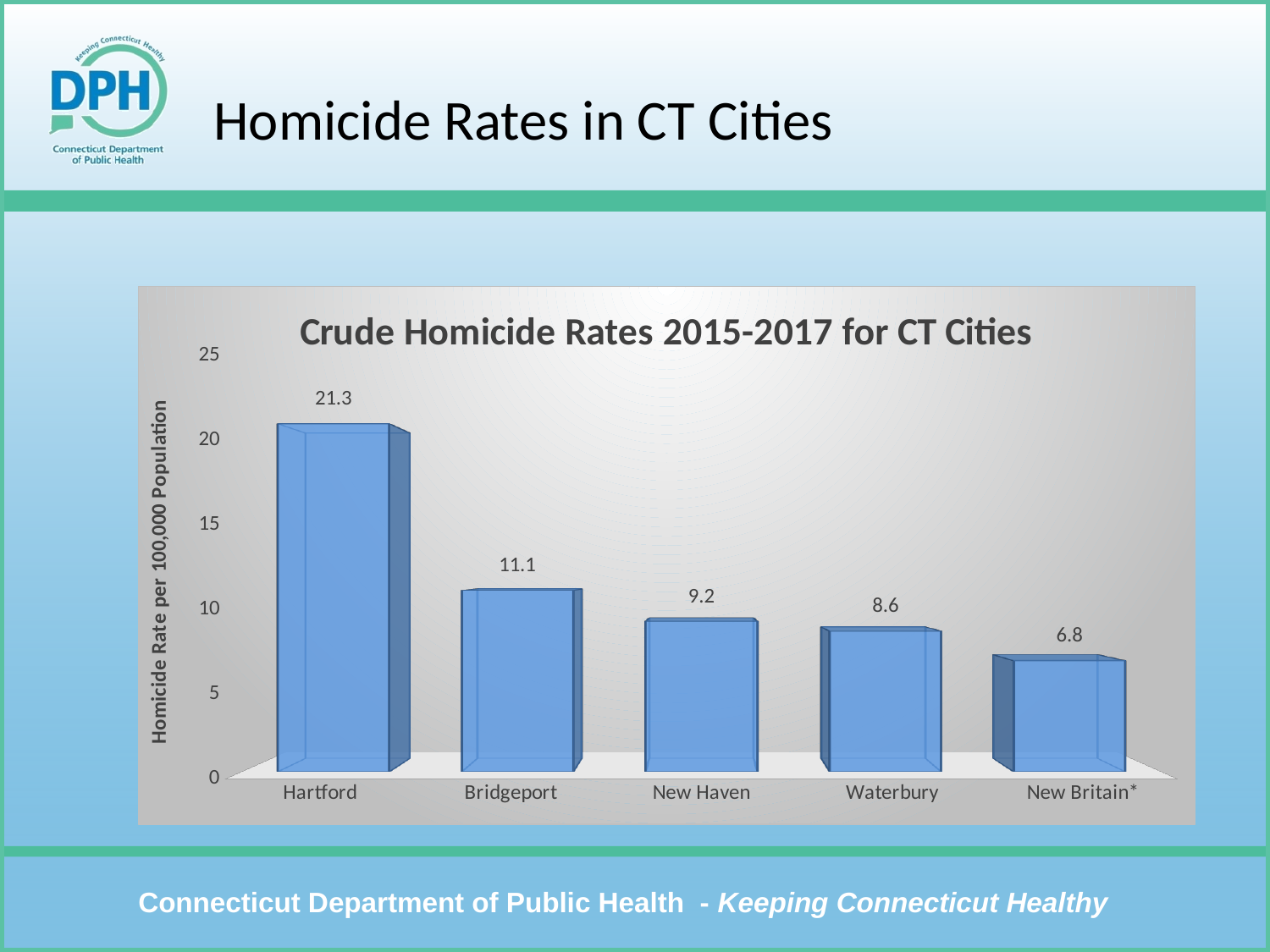
Which city has a higher homicide rate, Bridgeport or Waterbury? Bridgeport Which city has the highest crude homicide rate? Hartford What is the title of the chart? Crude Homicide Rates 2015-2017 for CT Cities Which city has the lowest crude homicide rate? New Britain* What is the crude homicide rate for New Britain*? 6.8 What is the crude homicide rate for Hartford? 21.3 Is the value for Hartford greater or less than 20? greater What is the difference between the homicide rates of Waterbury and New Britain*? 1.8 What is the difference between the homicide rates of Hartford and Bridgeport? 10.2 What is the crude homicide rate for New Haven? 9.2 What kind of chart is shown on the slide? Bar chart How many cities are shown in the chart? 5